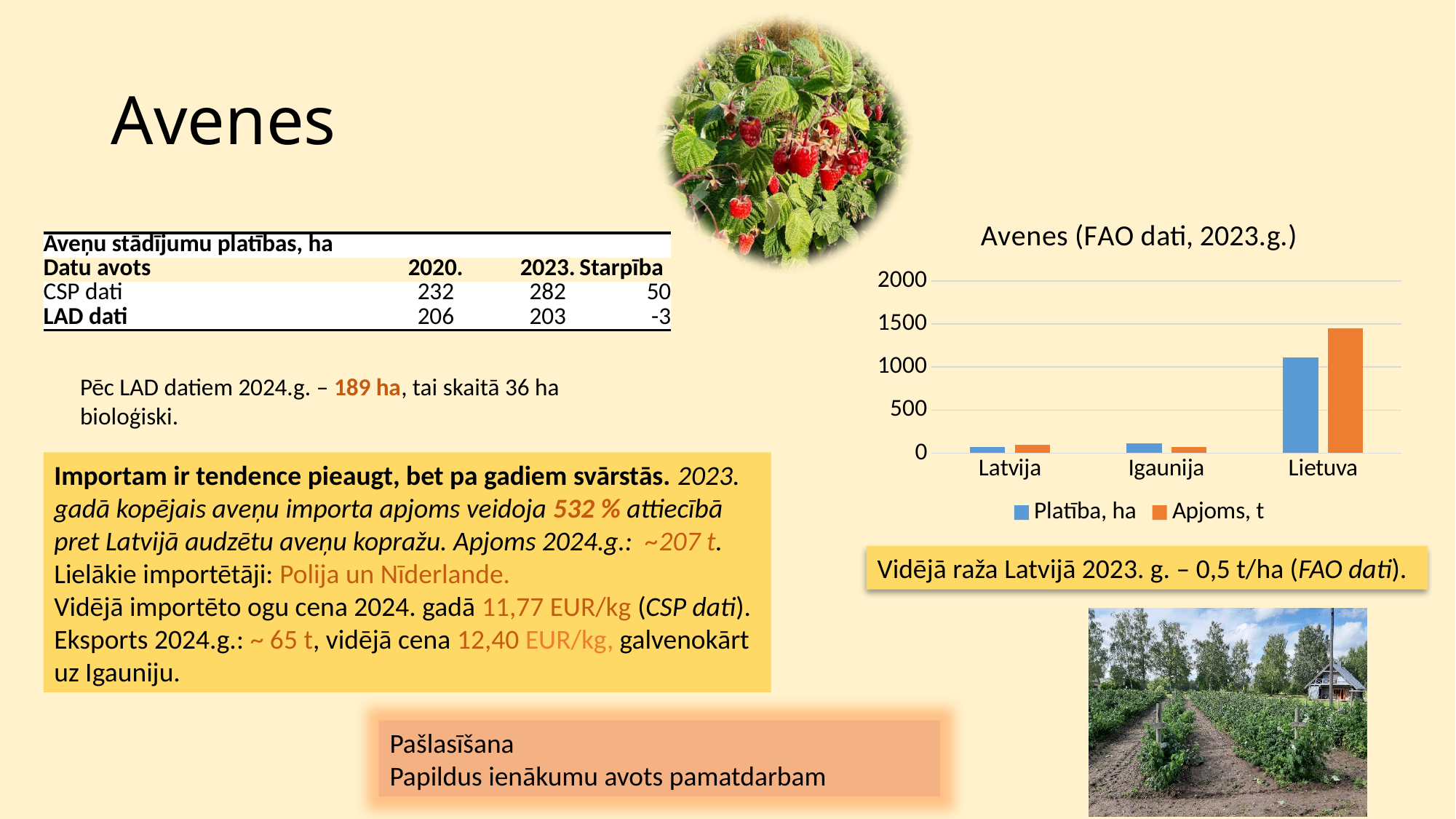
Which country has the highest value for Platība, ha? Lietuva What kind of chart is shown on the slide? bar chart For Lietuva, which is larger: Platība, ha or Apjoms, t? Apjoms, t Which country has a larger value for Apjoms, t: Latvija or Lietuva? Lietuva Is the value for Platība, ha for Lietuva greater or less than 1500? less Is the value for Apjoms, t for Lietuva greater or less than 1000? greater Which series is shown in orange in the chart? Apjoms, t Which country has the highest value for Apjoms, t? Lietuva How many series does the chart legend list? 2 What is the title of the chart? Avenes (FAO dati, 2023.g.) How many countries are shown on the x axis of the chart? 3 Is the value for Apjoms, t for Latvija greater or less than 500? less